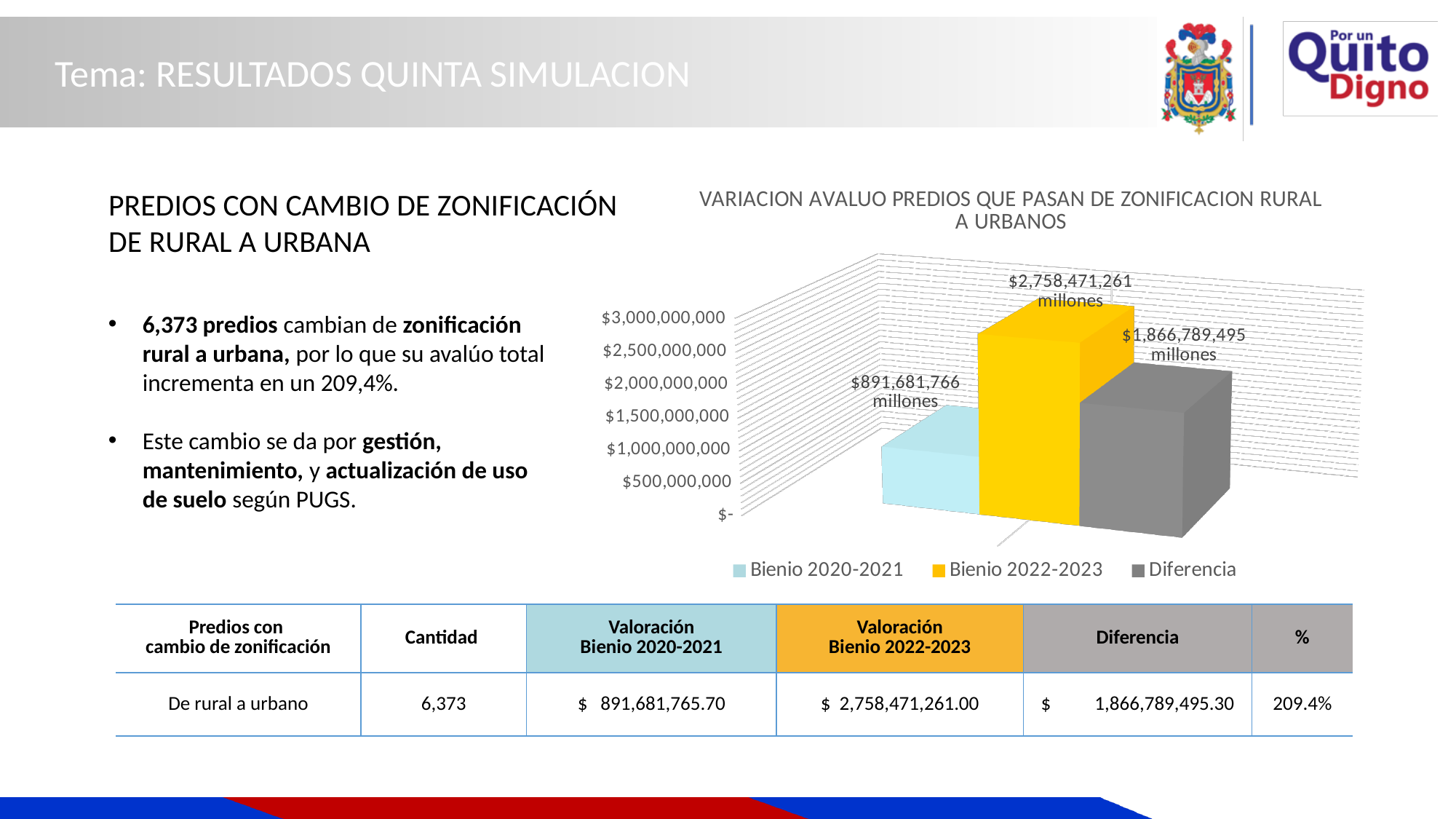
Which series has the highest value in the chart? Bienio 2022-2023 Is the value for Bienio 2020-2021 greater or less than $1,000,000,000? less How many series does the chart legend list? 3 What is the difference between the Bienio 2022-2023 value and the Bienio 2020-2021 value? $1,866,789,495 millones What is the value shown for Bienio 2020-2021? $891,681,766 millones What is the value shown for Bienio 2022-2023? $2,758,471,261 millones Which is larger, the value for Bienio 2020-2021 or the value for Diferencia? Diferencia Is the value for Bienio 2022-2023 greater or less than $2,500,000,000? greater What type of chart is shown on the slide? Bar chart What is the value shown for Diferencia? $1,866,789,495 millones What is the title of the chart? VARIACION AVALUO PREDIOS QUE PASAN DE ZONIFICACION RURAL A URBANOS Which series has the lowest value in the chart? Bienio 2020-2021